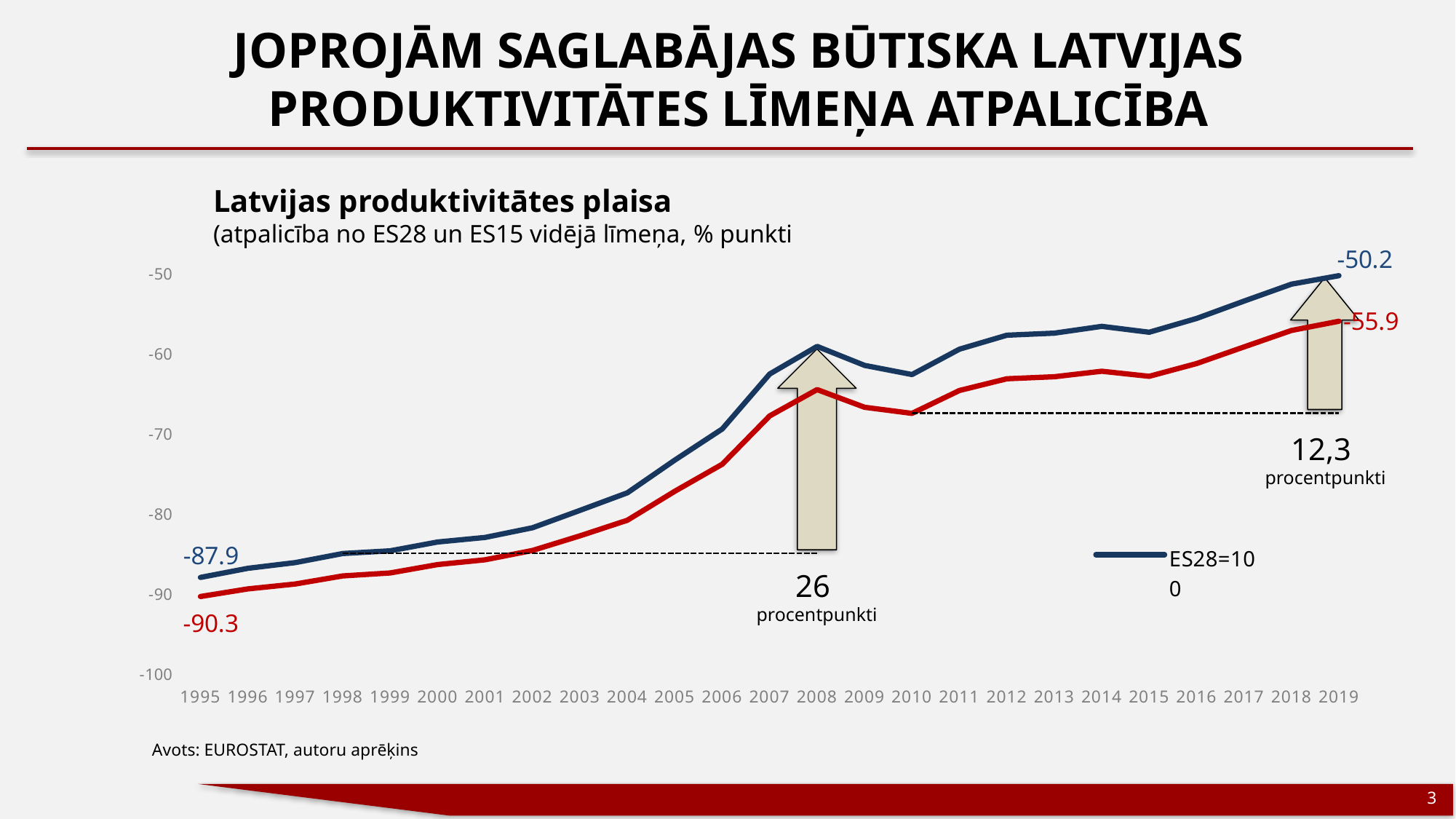
In 2019, which line has the higher value, the blue ES28=100 line or the red line? ES28=100 (blue) Do the values of the ES28=100 series generally rise or fall from 1995 to 2019? Rise By how much did the ES28=100 series change from 1995 to 2019? 37.7 What is the value of the ES28=100 series in 2019? -50.2 What is the value of the ES28=100 series in 1995? -87.9 What is the difference between the ES28=100 value and the red line value in 2019? 5.7 By how much did the red line change from 1995 to 2019? 34.4 What is the value of the red line in 2019? -55.9 Is the value of the ES28=100 series in 2005 greater or less than -70? less What kind of chart is shown on the slide? Line chart How many years are shown on the x axis? 25 What is the value of the red line in 1995? -90.3